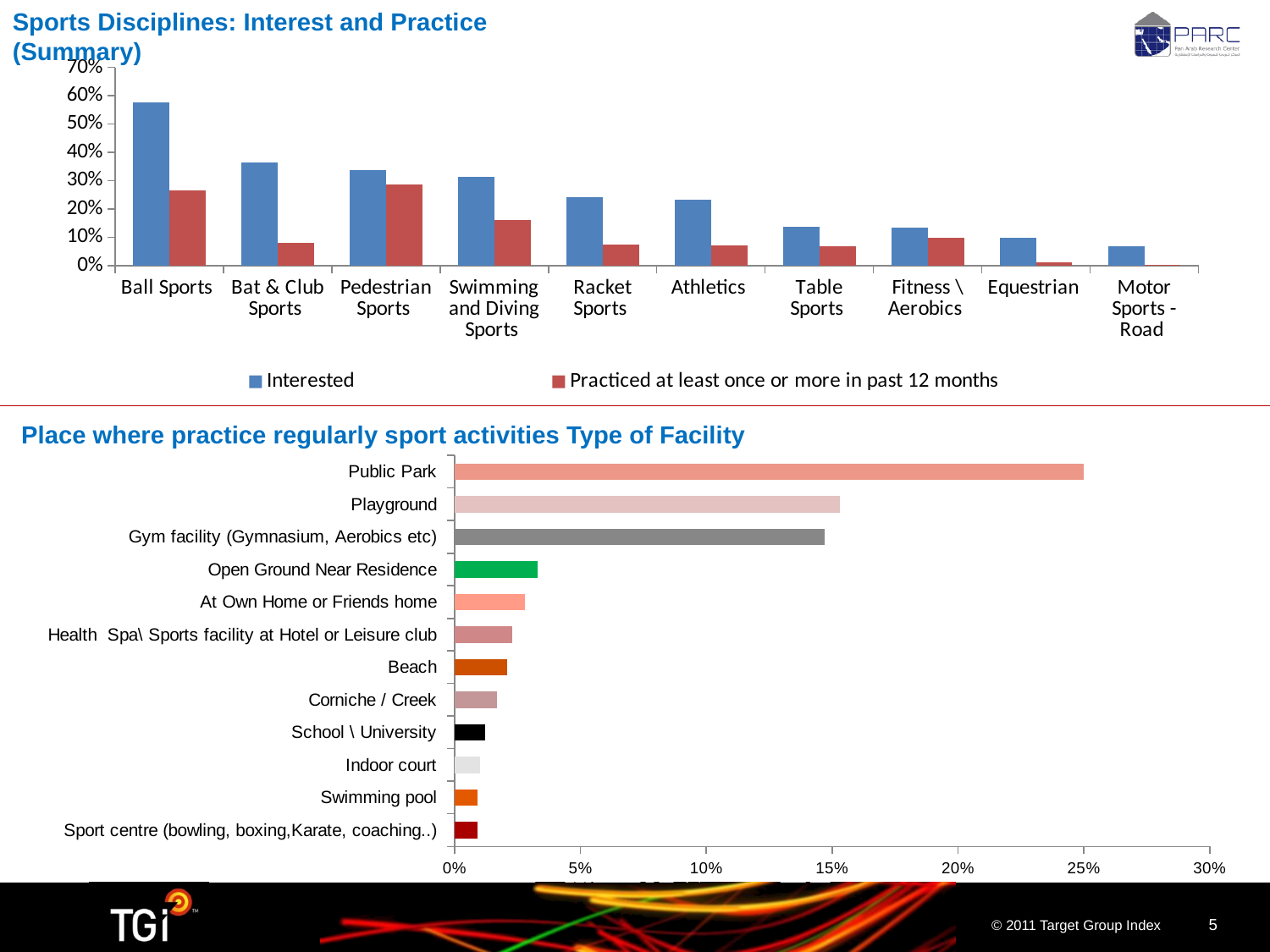
In the bottom chart 'Place where practice regularly sport activities Type of Facility', is the value for Open Ground Near Residence greater or less than 5%? less In the top chart 'Sports Disciplines: Interest and Practice (Summary)', which series is shown in blue? Interested In the top chart 'Sports Disciplines: Interest and Practice (Summary)', is the 'Practiced at least once or more in past 12 months' value for Pedestrian Sports greater or less than 20%? greater In the top chart 'Sports Disciplines: Interest and Practice (Summary)', how many series does the legend list? 2 In the top chart 'Sports Disciplines: Interest and Practice (Summary)', do the 'Interested' values generally rise or fall from left to right along the x axis? fall In the bottom chart 'Place where practice regularly sport activities Type of Facility', how many facility types are listed? 12 In the top chart 'Sports Disciplines: Interest and Practice (Summary)', which category has the highest 'Interested' value? Ball Sports In the top chart 'Sports Disciplines: Interest and Practice (Summary)', is the 'Interested' value for Ball Sports greater or less than 50%? greater What kind of chart is the top chart titled 'Sports Disciplines: Interest and Practice (Summary)'? Bar chart In the bottom chart 'Place where practice regularly sport activities Type of Facility', which facility has the highest value? Public Park In the top chart 'Sports Disciplines: Interest and Practice (Summary)', how many sports discipline categories are shown on the x axis? 10 In the top chart 'Sports Disciplines: Interest and Practice (Summary)', which category has the lowest 'Practiced at least once or more in past 12 months' value? Motor Sports - Road